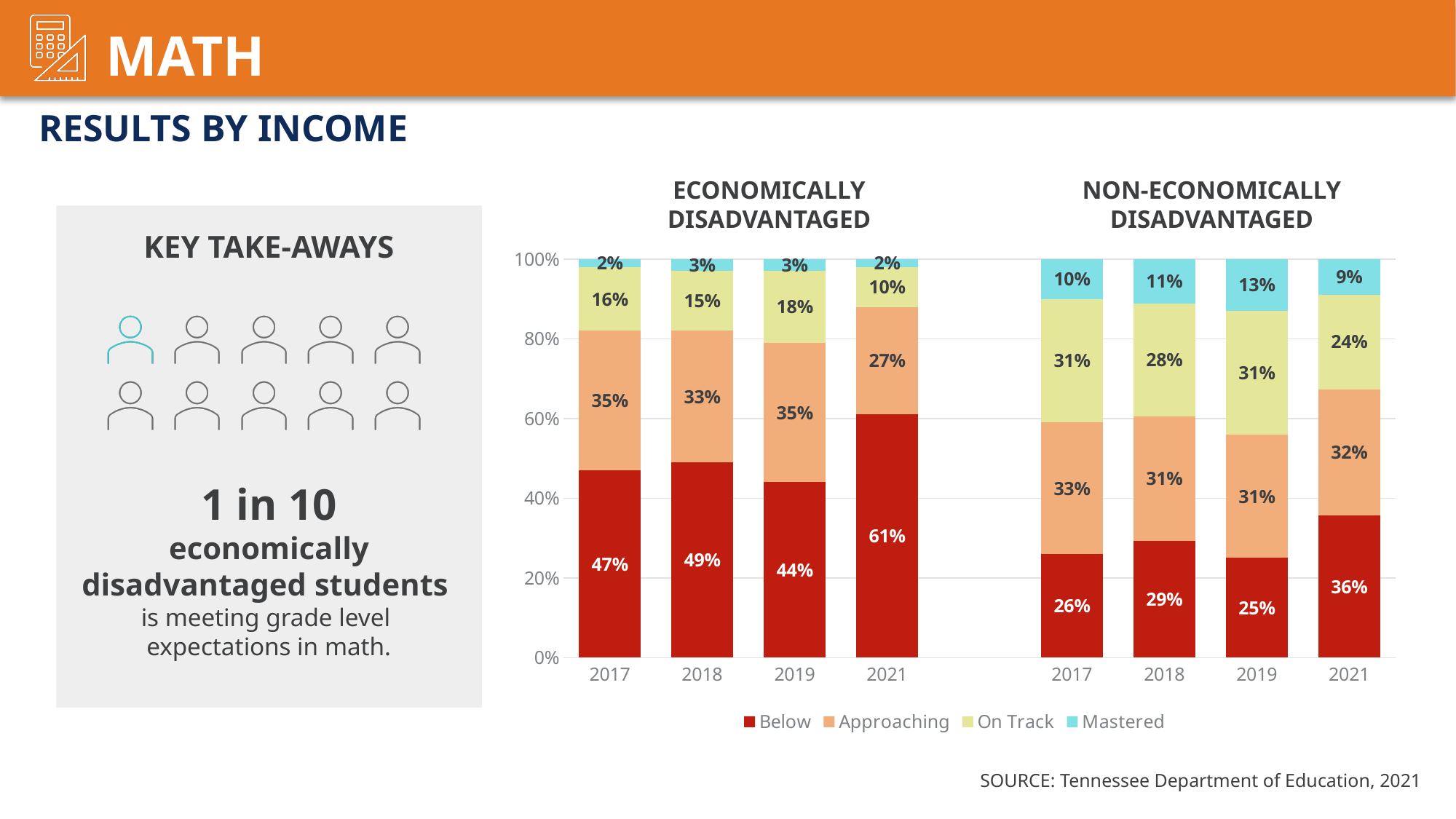
What percentage of economically disadvantaged students were On Track in 2019? 18% What percentage of economically disadvantaged students were Below in 2021? 61% In which year was the Below share highest for economically disadvantaged students? 2021 What kind of chart is shown on the slide? Stacked bar chart How many series does the legend list? 4 Which group had a larger Mastered share in 2018, economically disadvantaged or non-economically disadvantaged students? Non-economically disadvantaged How many years are shown for each income group? 4 What percentage of non-economically disadvantaged students were Approaching in 2021? 32% What is the difference between the Below share for economically disadvantaged students and non-economically disadvantaged students in 2021? 25% Which colour represents the Mastered category in the chart? Light blue In which year was the Below share lowest for non-economically disadvantaged students? 2019 What percentage of non-economically disadvantaged students were Mastered in 2019? 13%